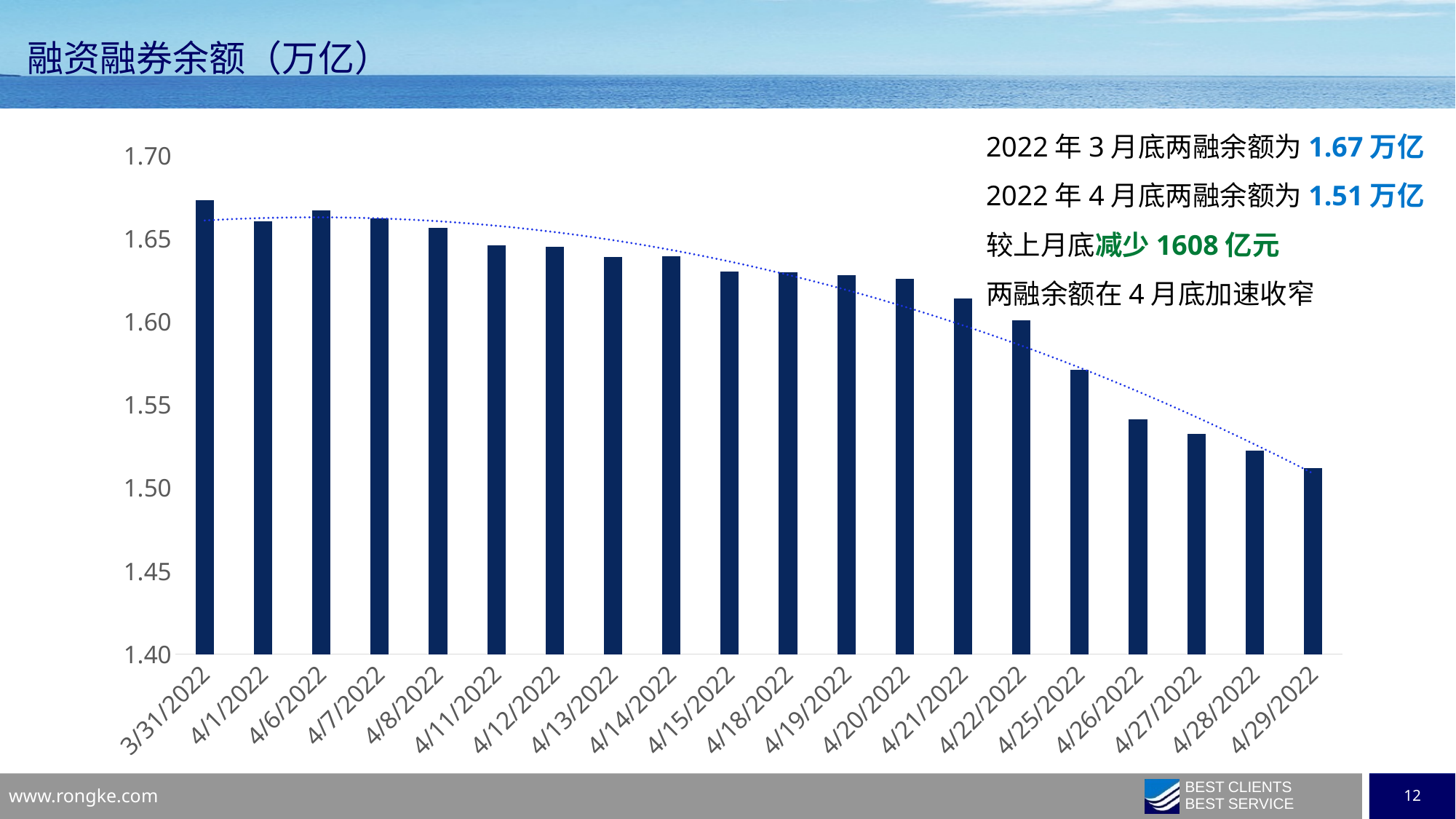
Is the value for 3/31/2022 greater or less than 1.65? greater What kind of chart is shown on the slide? bar chart Which is larger, the value for 4/20/2022 or the value for 4/21/2022? 4/20/2022 Do the values generally rise or fall from 3/31/2022 to 4/29/2022? fall Which date has the highest margin balance on the chart? 3/31/2022 What is the title of the chart on the slide? 融资融券余额（万亿） Is the value for 4/25/2022 greater or less than 1.60? less Is the value for 4/29/2022 greater or less than 1.55? less How many dates (bars) are plotted on the chart? 20 What is the lowest value shown on the vertical axis of the chart? 1.40 Which date has the lowest margin balance on the chart? 4/29/2022